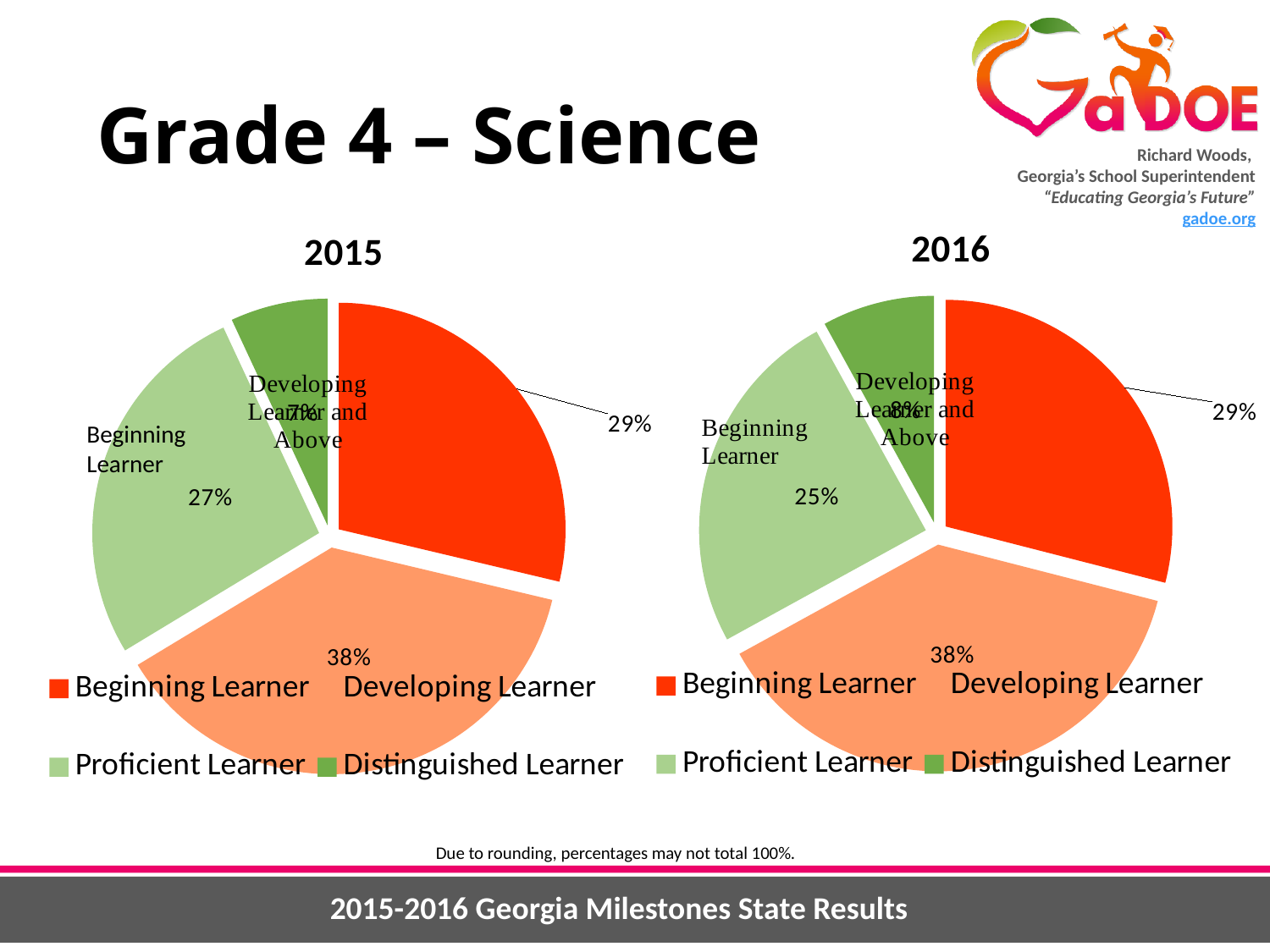
In the 2015 pie chart, which is larger: the Beginning Learner share or the Proficient Learner share? Beginning Learner In the 2016 pie chart, what percentage of students were Developing Learners? 38% In the 2015 pie chart, what percentage of students were Proficient Learners? 27% What is the difference between the Proficient Learner percentage in 2015 and in 2016? 2% In the 2016 pie chart, what percentage of students were Beginning Learners? 29% How many achievement levels does the legend of the 2016 pie chart list? 4 In the 2015 pie chart, what percentage of students were Beginning Learners? 29% In the 2015 pie chart, which achievement level has the largest share? Developing Learner In the 2015 pie chart, what percentage of students were Developing Learners? 38% What type of chart is used to show the 2015 results? Pie chart In the 2016 pie chart, what percentage of students were Proficient Learners? 25% In the 2016 pie chart, which achievement level has the smallest share? Distinguished Learner